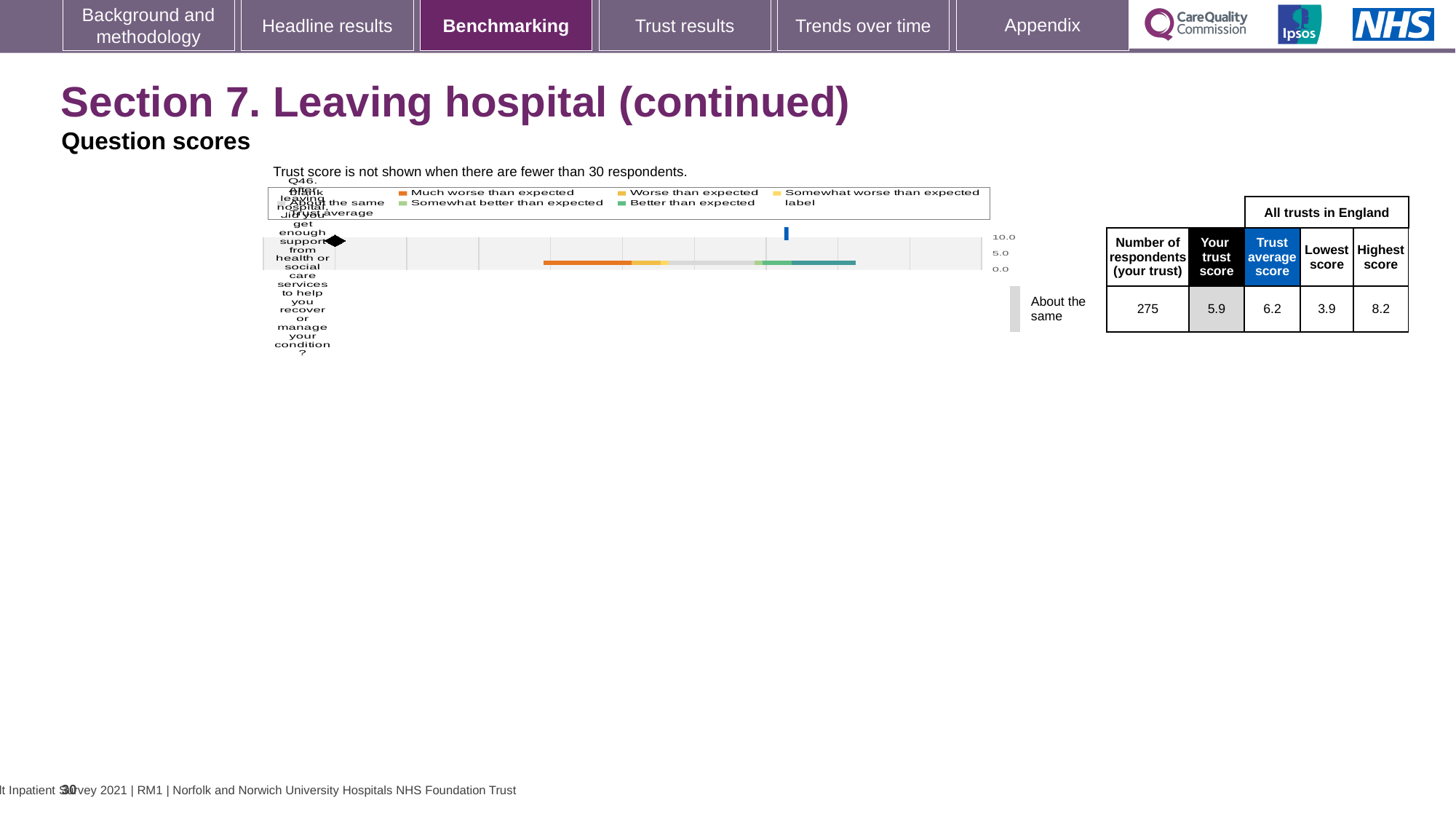
What is the trust's score for Q46 (support from health or social care services after leaving hospital)? 5.9 Which is larger for Q46: the trust's own score or the trust average score? Trust average score What kind of chart is used to show the Q46 benchmarking result? bar chart What is the lowest score among all trusts in England for Q46? 3.9 What is the difference between the highest and lowest scores for Q46 across all trusts in England? 4.3 What is the highest score among all trusts in England for Q46? 8.2 How many questions are plotted on the chart? 1 How many respondents from the trust answered Q46? 275 What benchmarking category is the trust's Q46 result placed in? About the same By how much does the trust average score exceed the trust's own score for Q46? 0.3 Is the trust's score for Q46 greater or less than 5.0? greater What is the trust average score across all trusts in England for Q46? 6.2